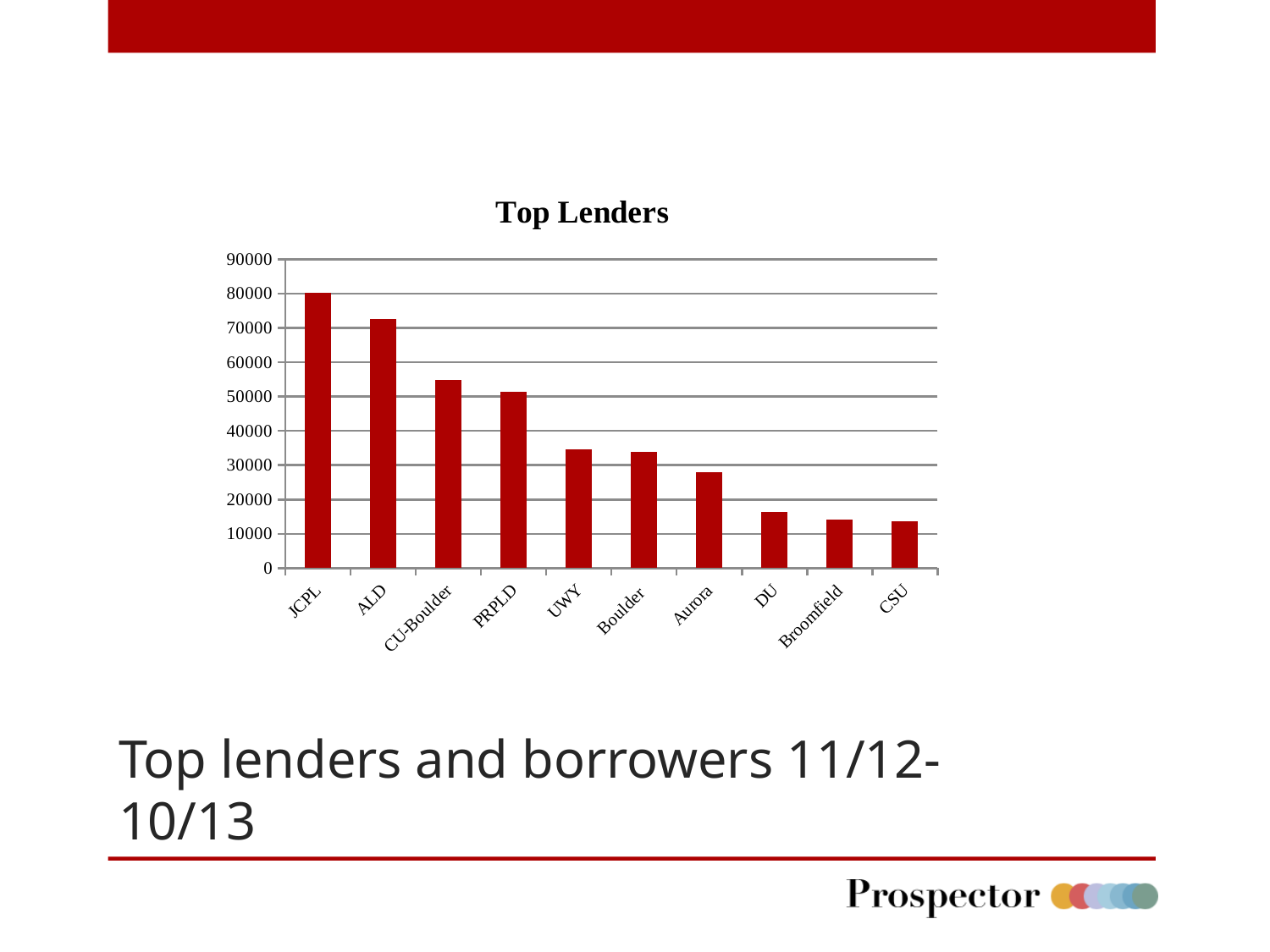
Is the value for Aurora greater or less than 30000? less How many lenders are shown in the chart? 10 Is the value for PRPLD greater or less than 50000? greater Which lender has the highest value in the chart? JCPL Do the values rise or fall moving from left to right along the x axis? fall Which has a larger value, ALD or CU-Boulder? ALD What kind of chart is shown on the slide? bar chart Is the value for DU greater or less than 20000? less What is the title of the chart? Top Lenders Which lender has the lowest value in the chart? CSU